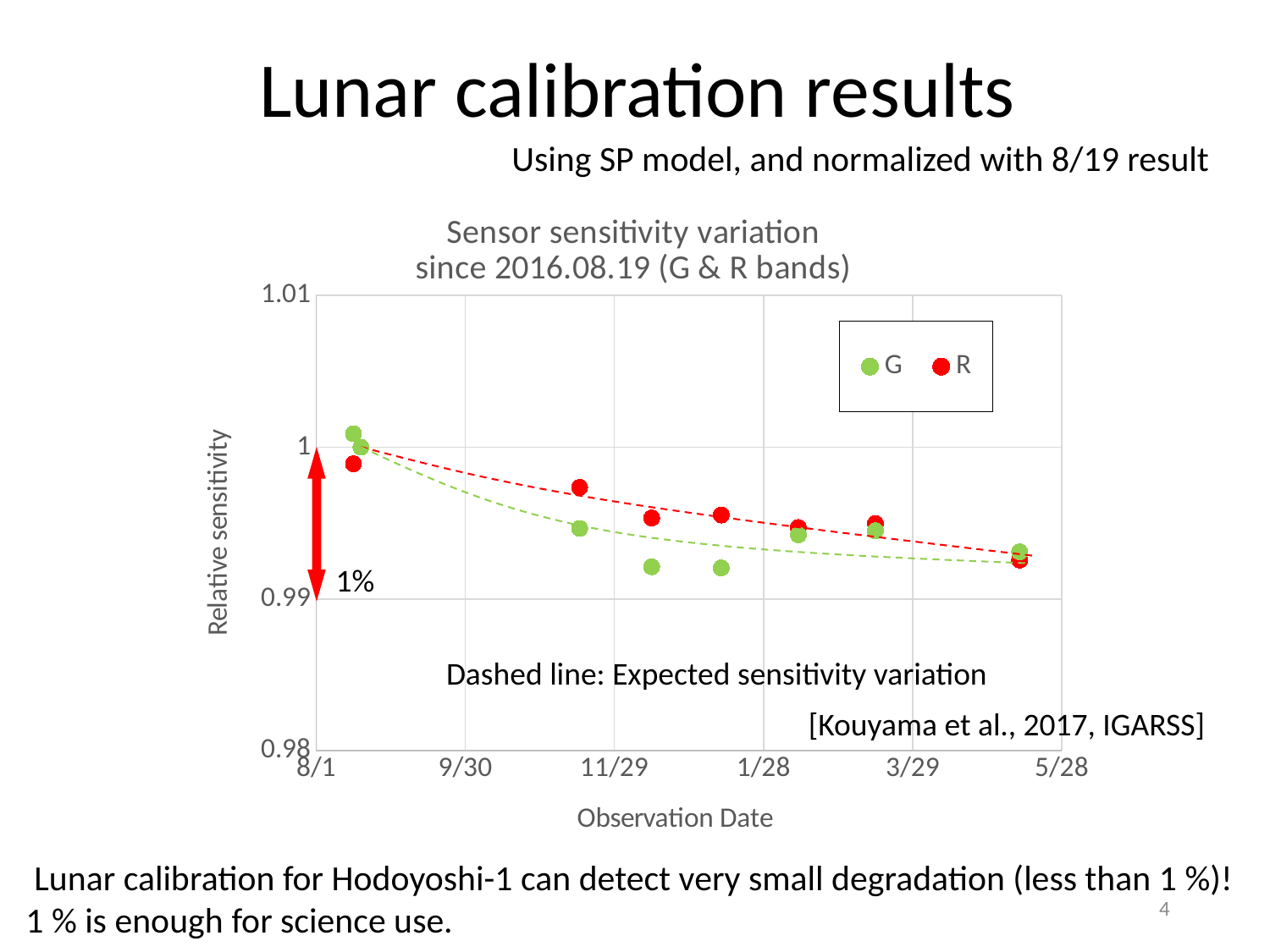
Which series contains the highest plotted point on the chart? G What are the two series named in the legend? G and R Is the first G value (near 8/1) greater or less than 1? greater How many series does the legend list? 2 Is the first R value (near 8/1) greater or less than 1? less Around mid-November, which series has the higher relative sensitivity, G or R? R Do the relative sensitivity values generally rise or fall from 8/1 to 5/28? fall Is the lowest G value greater or less than 0.99? greater What is the title of the x axis? Observation Date Which series contains the lowest plotted point on the chart? G What kind of chart is shown on the slide? scatter chart